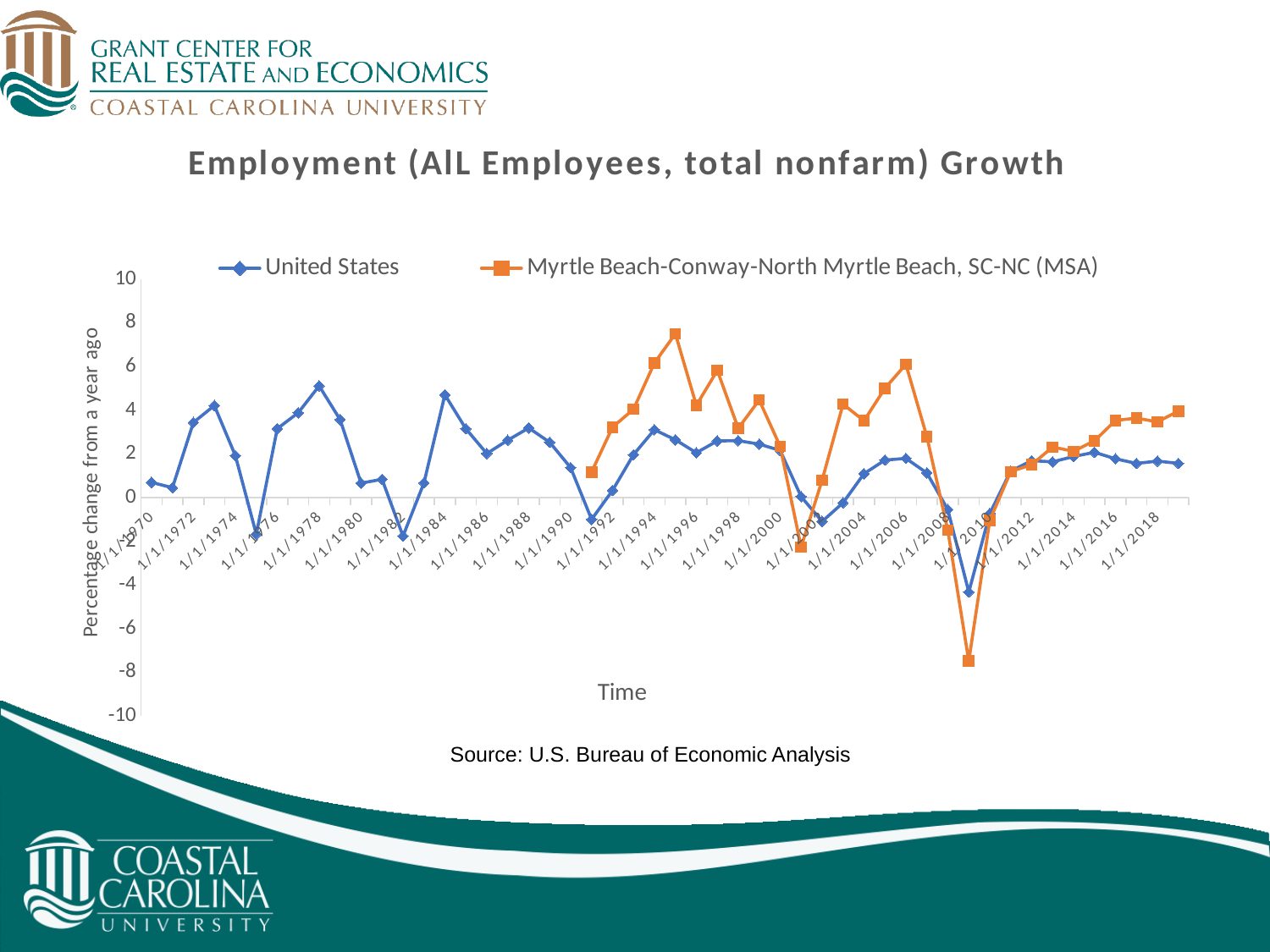
Which series has the higher value at 1/1/1994, United States or Myrtle Beach-Conway-North Myrtle Beach, SC-NC (MSA)? Myrtle Beach-Conway-North Myrtle Beach, SC-NC (MSA) Is the value for United States at 1/1/1978 greater or less than 4? greater Which series has the lower value at 1/1/2010, United States or Myrtle Beach-Conway-North Myrtle Beach, SC-NC (MSA)? Myrtle Beach-Conway-North Myrtle Beach, SC-NC (MSA) What kind of chart is shown on the slide? line chart Do the values for Myrtle Beach-Conway-North Myrtle Beach, SC-NC (MSA) rise or fall from 1/1/2010 to 1/1/2018? rise How many series does the legend list? 2 Around which year does the Myrtle Beach-Conway-North Myrtle Beach, SC-NC (MSA) series reach its lowest value? 1/1/2009 Is the value for Myrtle Beach-Conway-North Myrtle Beach, SC-NC (MSA) at 1/1/2010 greater or less than -6? greater What is the title of the chart? Employment (AlL Employees, total nonfarm) Growth What is the label of the vertical axis? Percentage change from a year ago Is the highest value for Myrtle Beach-Conway-North Myrtle Beach, SC-NC (MSA) greater or less than 6? greater